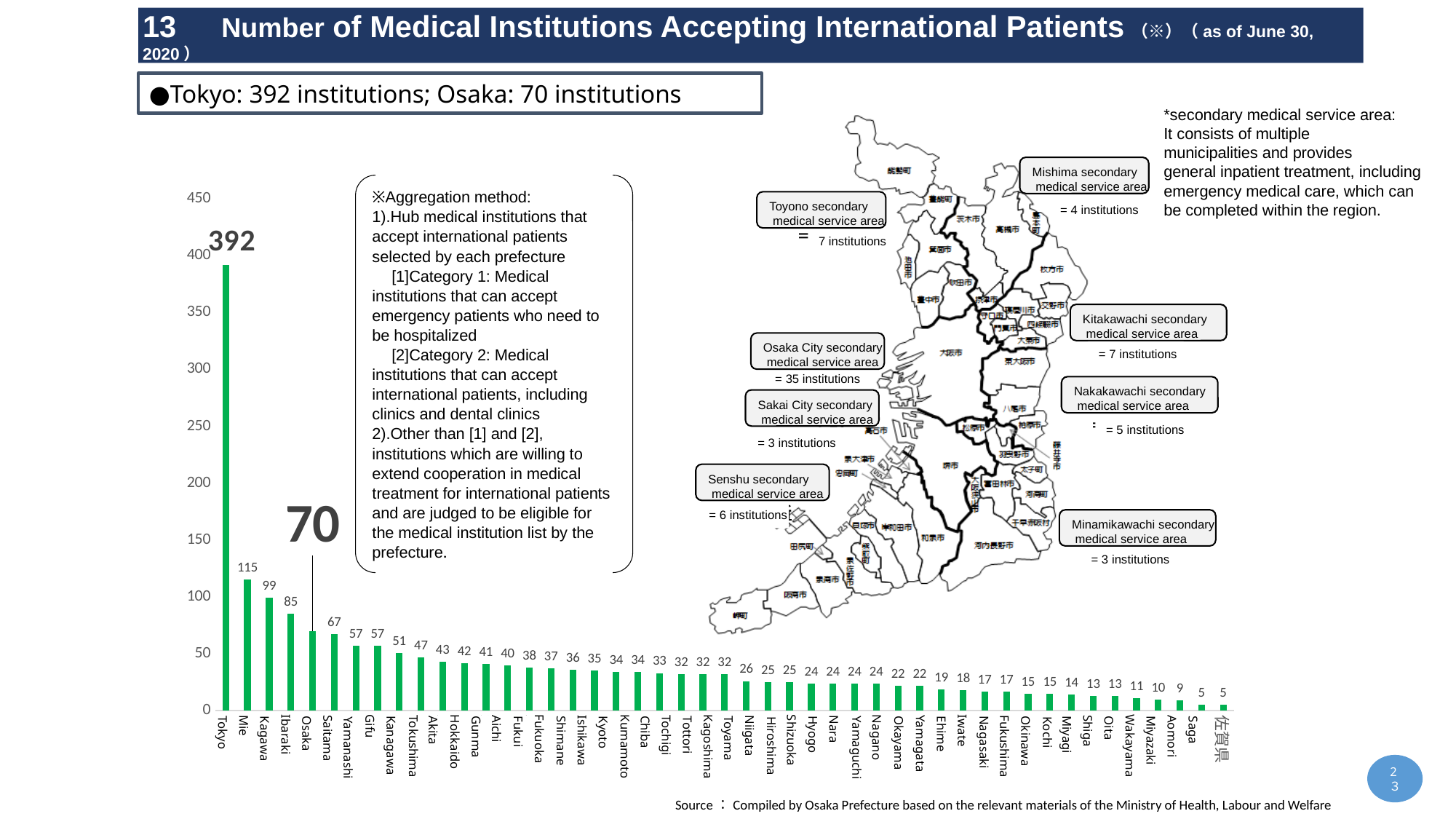
Do the values rise or fall moving from left to right along the x axis? Fall Which prefecture has the highest number of medical institutions accepting international patients? Tokyo What is the difference between the values for Tokyo and Osaka? 322 What kind of chart is used to show the number of medical institutions by prefecture? Bar chart Is the value for Mie greater or less than 100? greater What is the value shown for Saitama? 67 Which has a larger value, Kagawa or Ibaraki? Kagawa What is the value shown for Mie? 115 What is the number of medical institutions accepting international patients in Tokyo? 392 What colour are the bars in the chart? Green What is the number of medical institutions accepting international patients in Osaka? 70 What is the difference between the values for Mie and Kagawa? 16